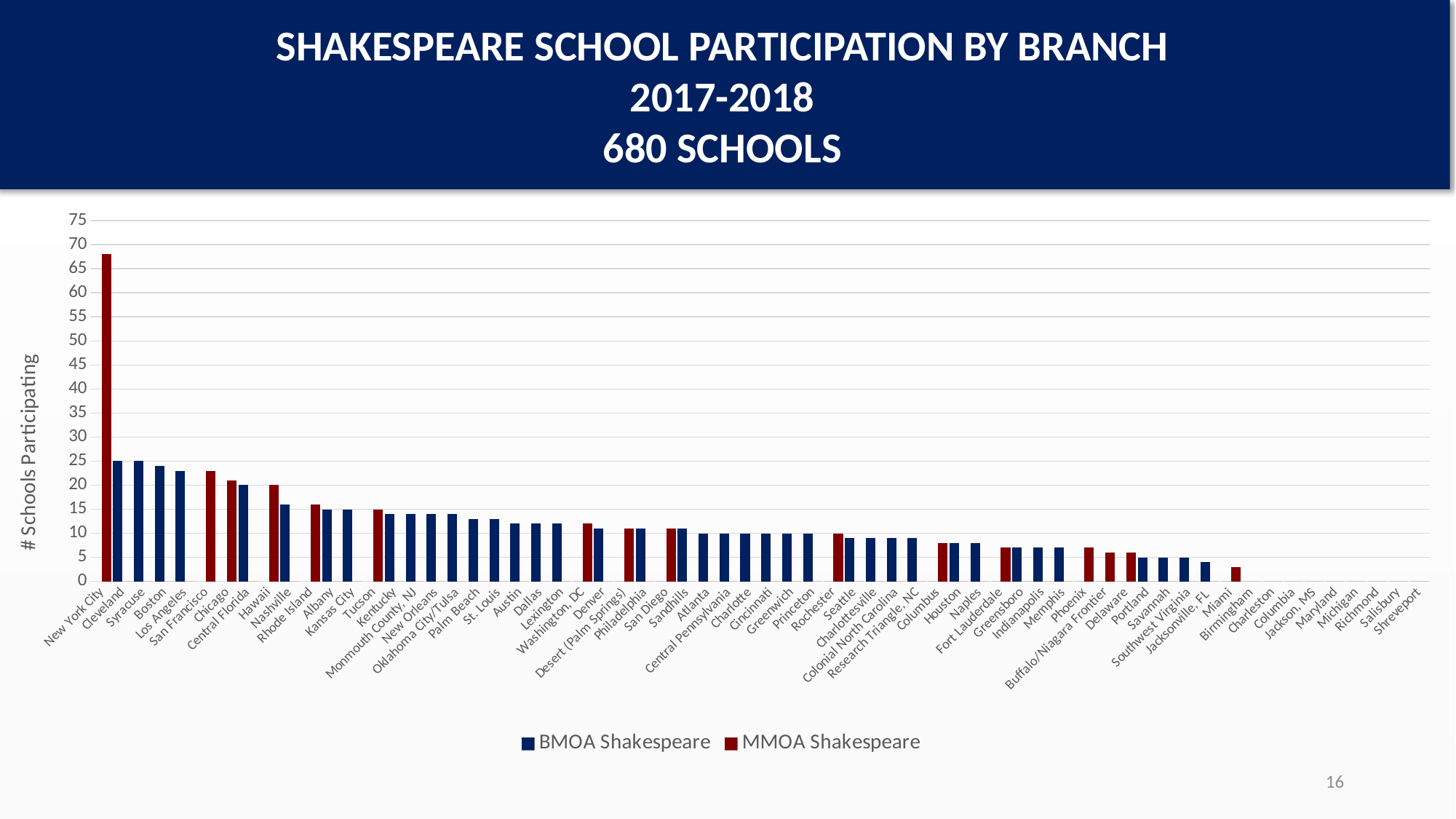
What kind of chart is shown on the slide? bar chart What is the label on the vertical axis? # Schools Participating Is the value for Miami greater or less than 5? less Which series is shown in red? MMOA Shakespeare Is the value for Washington, DC greater or less than 10? greater Which branch has the highest number of schools participating? New York City Is the value for Boston greater or less than 20? greater Do the values generally rise or fall moving from left to right along the x axis? fall Which has more schools participating, New York City or Cleveland? New York City Which has more schools participating, Chicago or Miami? Chicago How many series does the legend list? 2